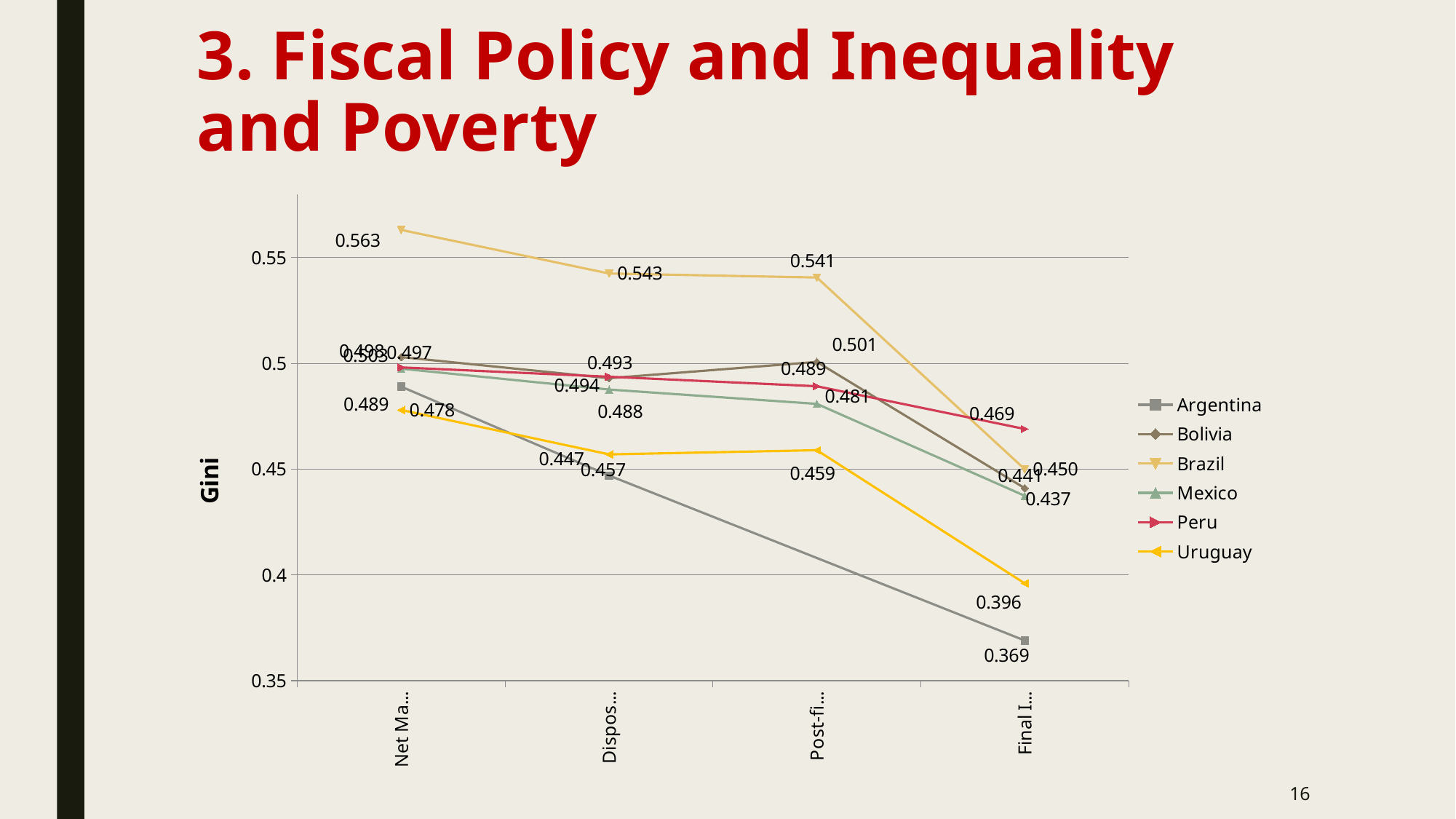
Which country has the lowest Gini value at the last category (Final I...)? Argentina What is the difference between Brazil's Gini at the first category (0.563) and at the last category (0.450)? 0.113 What is the Gini value for Brazil at the first category (Net Ma...)? 0.563 What type of chart is shown on the slide? line chart What is the Gini value for Uruguay at the last category (Final I...)? 0.396 What is the label on the y axis? Gini How many categories are plotted along the x axis? 4 What is the Gini value for Argentina at the last category (Final I...)? 0.369 Does the Gini value for Argentina rise or fall from the first category to the last? fall How many series does the legend list? 6 What is the Gini value for Mexico at the last category (Final I...)? 0.437 Which country has the highest Gini value at the last category (Final I...)? Peru